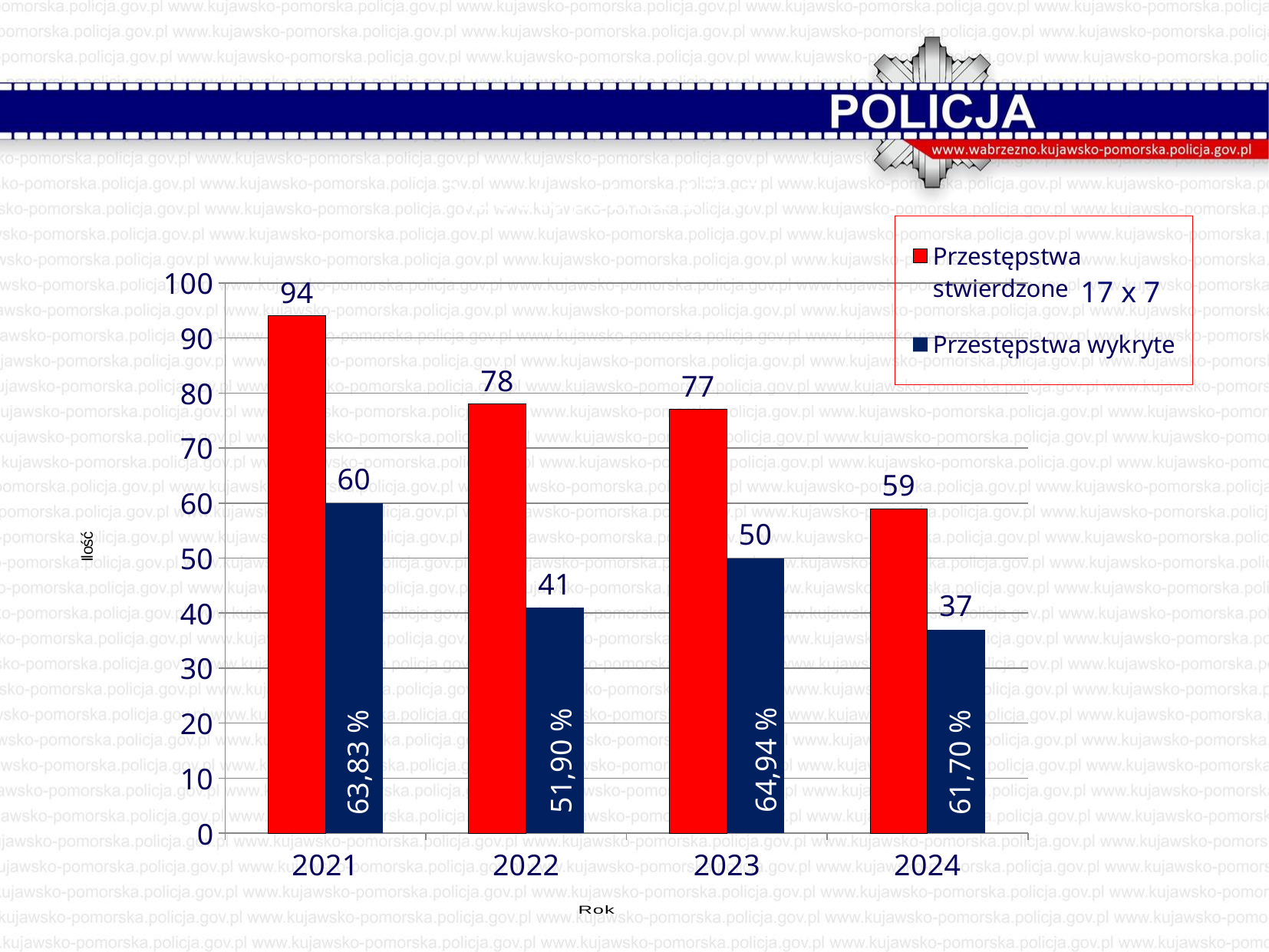
What percentage label is shown inside the Przestępstwa wykryte bar for 2022? 51,90 % In which year is Przestępstwa wykryte lowest? 2024 What is the label of the y axis? Ilość What is the value of Przestępstwa wykryte for 2023? 50 What is the value of Przestępstwa stwierdzone for 2021? 94 How many series does the legend list? 2 Is the value of Przestępstwa stwierdzone for 2022 greater or less than 70? greater What is the difference between Przestępstwa stwierdzone and Przestępstwa wykryte in 2024? 22 What kind of chart is shown on the slide? bar chart Which is larger: Przestępstwa wykryte in 2021 or Przestępstwa wykryte in 2023? Przestępstwa wykryte in 2021 In which year is Przestępstwa stwierdzone highest? 2021 How many years are shown on the x axis? 4